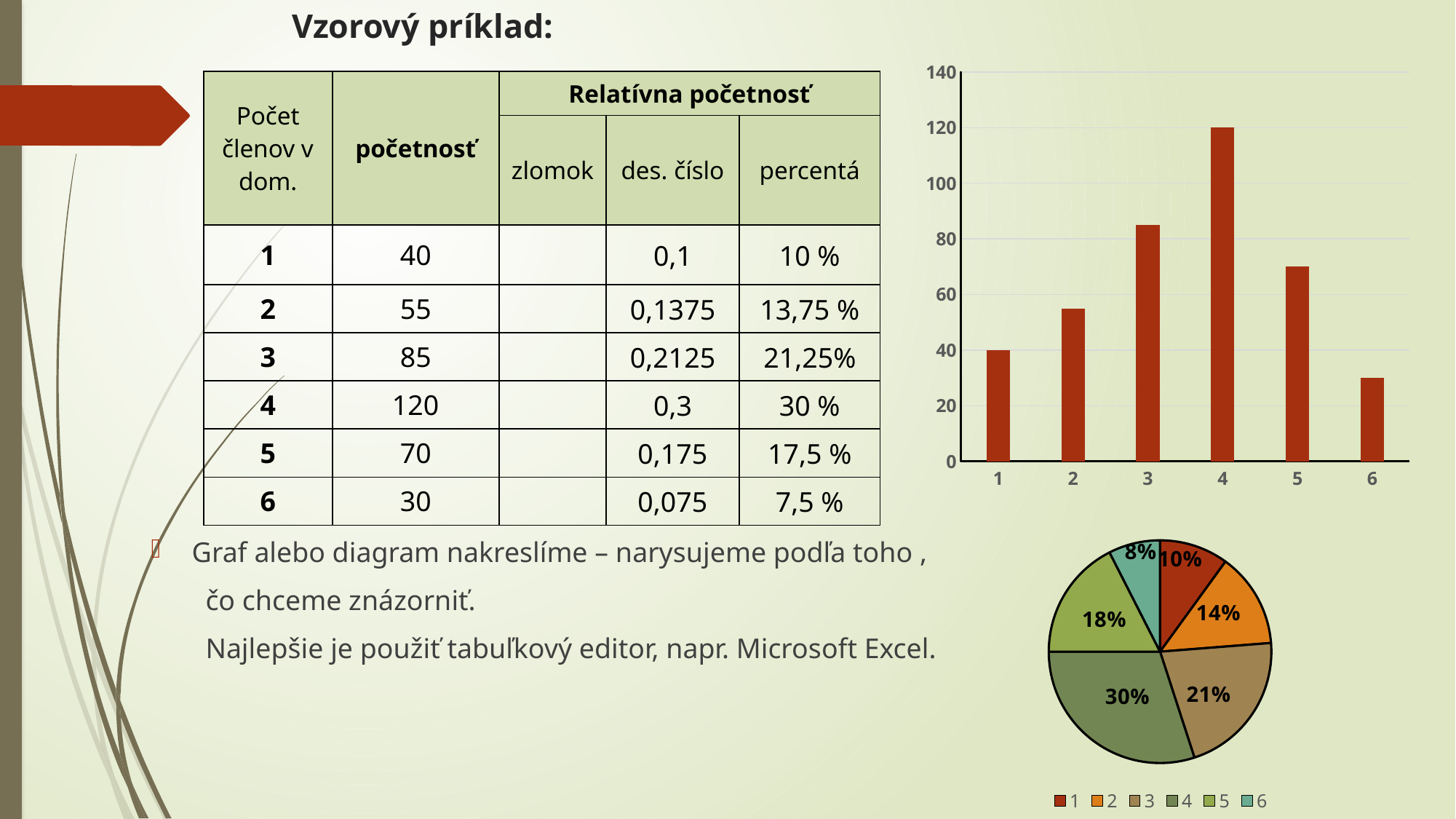
What kind of chart is the chart in the bottom right of the slide? pie chart In the bar chart, which category has the highest bar? 4 In the pie chart, what share does slice 4 have? 30% In the bar chart, what is the value for category 4? 120 In the bar chart, how many categories are shown on the x axis? 6 In the bar chart, which is larger, the bar for category 2 or the bar for category 5? 5 In the bar chart, which category has the lowest bar? 6 In the bar chart, what is the value for category 1? 40 In the pie chart, how many entries does the legend list? 6 What kind of chart is the chart in the top right of the slide? bar chart In the bar chart, is the value for category 3 greater or less than 80? greater In the bar chart, is the value for category 5 greater or less than 80? less